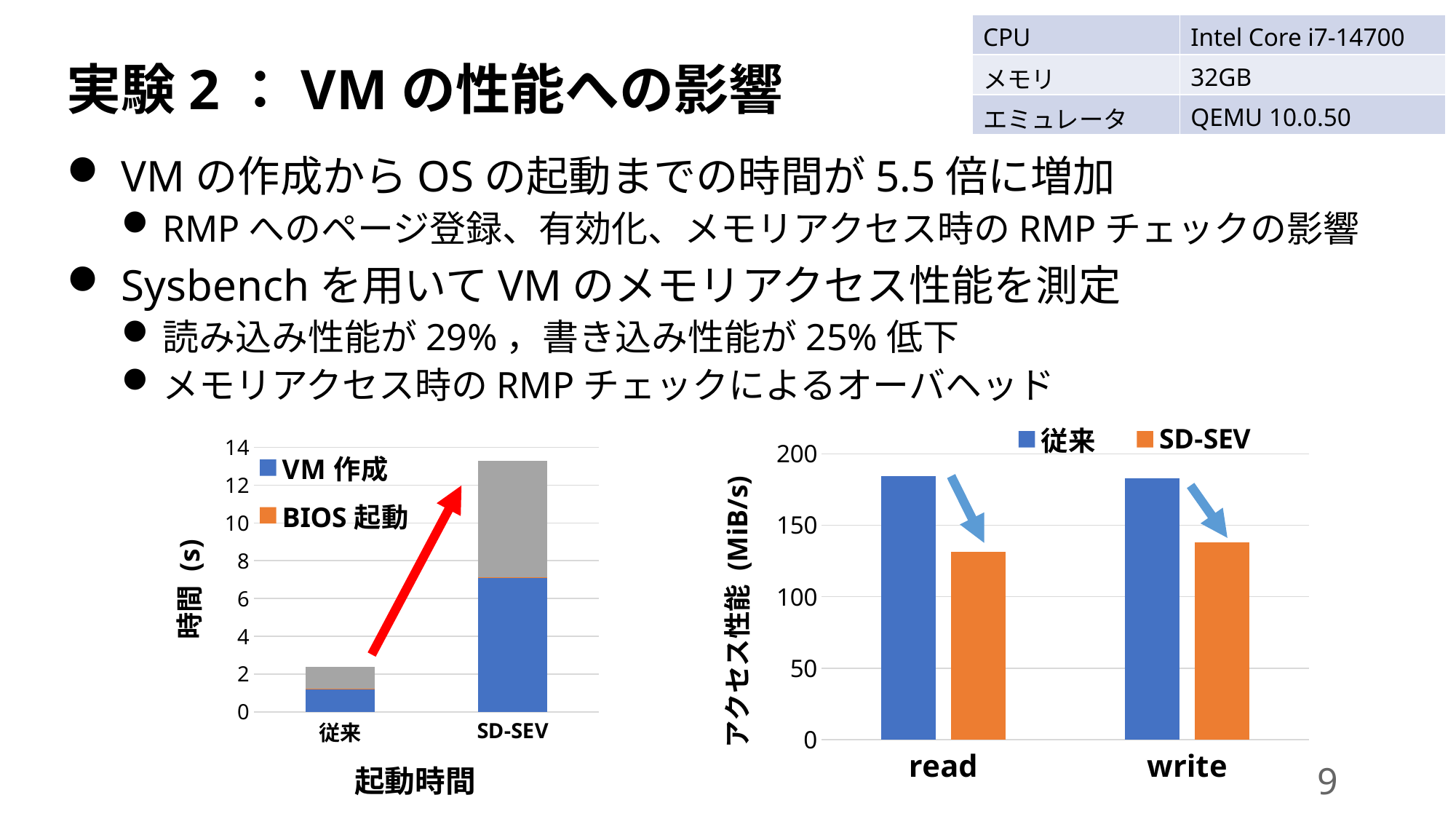
In the right chart showing アクセス性能 (MiB/s), which series has the higher value in the read category, 従来 or SD-SEV? 従来 In the left chart titled 起動時間, which category has the taller total bar, 従来 or SD-SEV? SD-SEV What kind of chart is the left chart titled 起動時間? bar chart In the left chart titled 起動時間, how many categories are shown on the x axis? 2 What kind of chart is the right chart showing アクセス性能 (MiB/s)? bar chart In the left chart titled 起動時間, is the total bar height for 従来 greater or less than 4? less In the right chart showing アクセス性能 (MiB/s), is the value for SD-SEV in the write category greater or less than 150? less In the right chart showing アクセス性能 (MiB/s), what is the label of the y axis? アクセス性能 (MiB/s) In the left chart titled 起動時間, is the total bar height for SD-SEV greater or less than 12? greater In the right chart showing アクセス性能 (MiB/s), how many series does the legend list? 2 In the right chart showing アクセス性能 (MiB/s), how many categories are shown on the x axis? 2